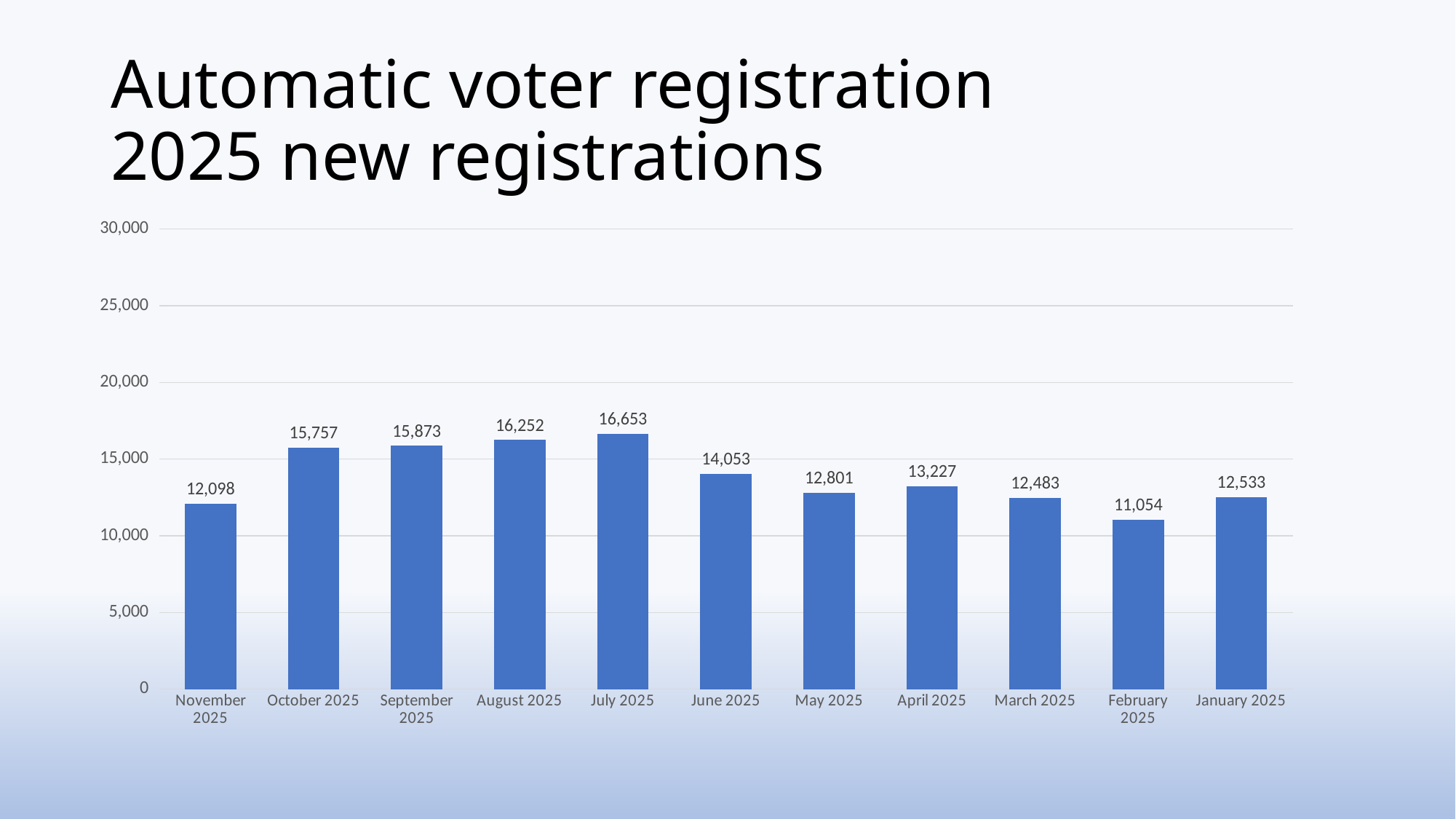
What is the difference between the values for July 2025 and February 2025? 5,599 Which is larger, the value for April 2025 or the value for May 2025? April 2025 What is the difference between the values for August 2025 and June 2025? 2,199 What kind of chart is shown on the slide? bar chart Is the value for June 2025 greater or less than 15,000? less Which month has the lowest number of new registrations? February 2025 How many months are plotted in the chart? 11 What is the value shown for September 2025? 15,873 What is the number of new registrations for February 2025? 11,054 What is the title of the slide? Automatic voter registration 2025 new registrations Which month has the highest number of new registrations? July 2025 What is the number of new registrations for July 2025? 16,653